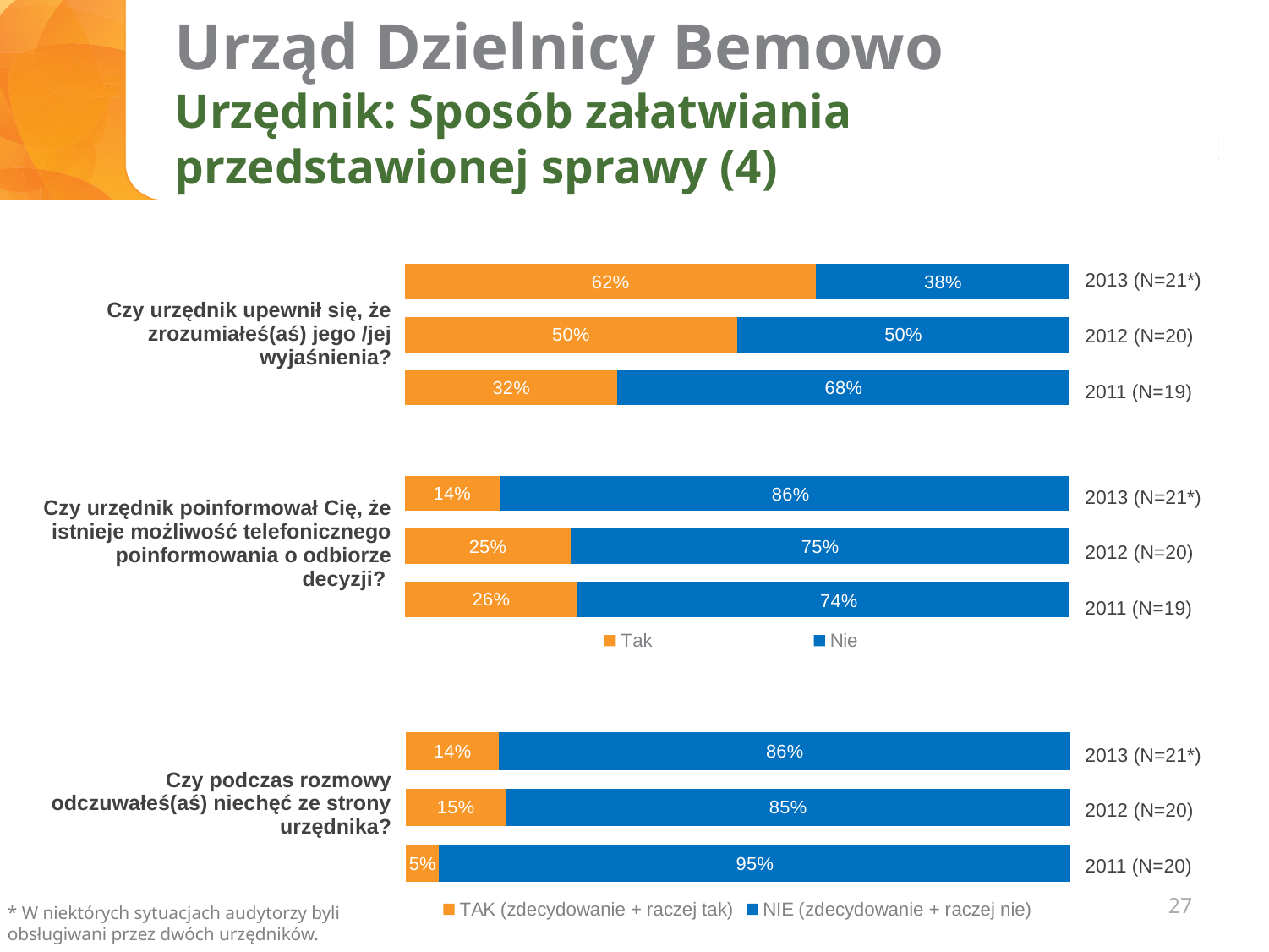
In the chart for 'Czy urzędnik upewnił się, że zrozumiałeś(aś) jego /jej wyjaśnienia?', which year has the highest 'Tak' share? 2013 (N=21*) In the chart for 'Czy urzędnik upewnił się, że zrozumiałeś(aś) jego /jej wyjaśnienia?', what is the difference between the 'Tak' values for 2013 and 2011? 30 percentage points In the chart for 'Czy urzędnik upewnił się, że zrozumiałeś(aś) jego /jej wyjaśnienia?', does the 'Tak' share rise or fall from 2011 to 2013? rise In the chart for 'Czy urzędnik upewnił się, że zrozumiałeś(aś) jego /jej wyjaśnienia?', what is the 'Tak' value for 2013 (N=21*)? 62% What type of chart is used for 'Czy podczas rozmowy odczuwałeś(aś) niechęć ze strony urzędnika?'? stacked bar chart In the chart for 'Czy podczas rozmowy odczuwałeś(aś) niechęć ze strony urzędnika?', which is larger: the 'TAK' value for 2012 or for 2011? 2012 In the chart for 'Czy podczas rozmowy odczuwałeś(aś) niechęć ze strony urzędnika?', what is the 'TAK' value for 2011 (N=20)? 5% In the chart for 'Czy urzędnik poinformował Cię, że istnieje możliwość telefonicznego poinformowania o odbiorze decyzji?', what is the 'Nie' value for 2013 (N=21*)? 86% In the chart for 'Czy podczas rozmowy odczuwałeś(aś) niechęć ze strony urzędnika?', how many years (bars) are shown? 3 In the chart for 'Czy urzędnik poinformował Cię, że istnieje możliwość telefonicznego poinformowania o odbiorze decyzji?', which year has the lowest 'Tak' share? 2013 (N=21*) In the chart for 'Czy urzędnik poinformował Cię, że istnieje możliwość telefonicznego poinformowania o odbiorze decyzji?', how many series does the legend list? 2 In the chart for 'Czy urzędnik upewnił się, że zrozumiałeś(aś) jego /jej wyjaśnienia?', what is the 'Nie' value for 2011 (N=19)? 68%